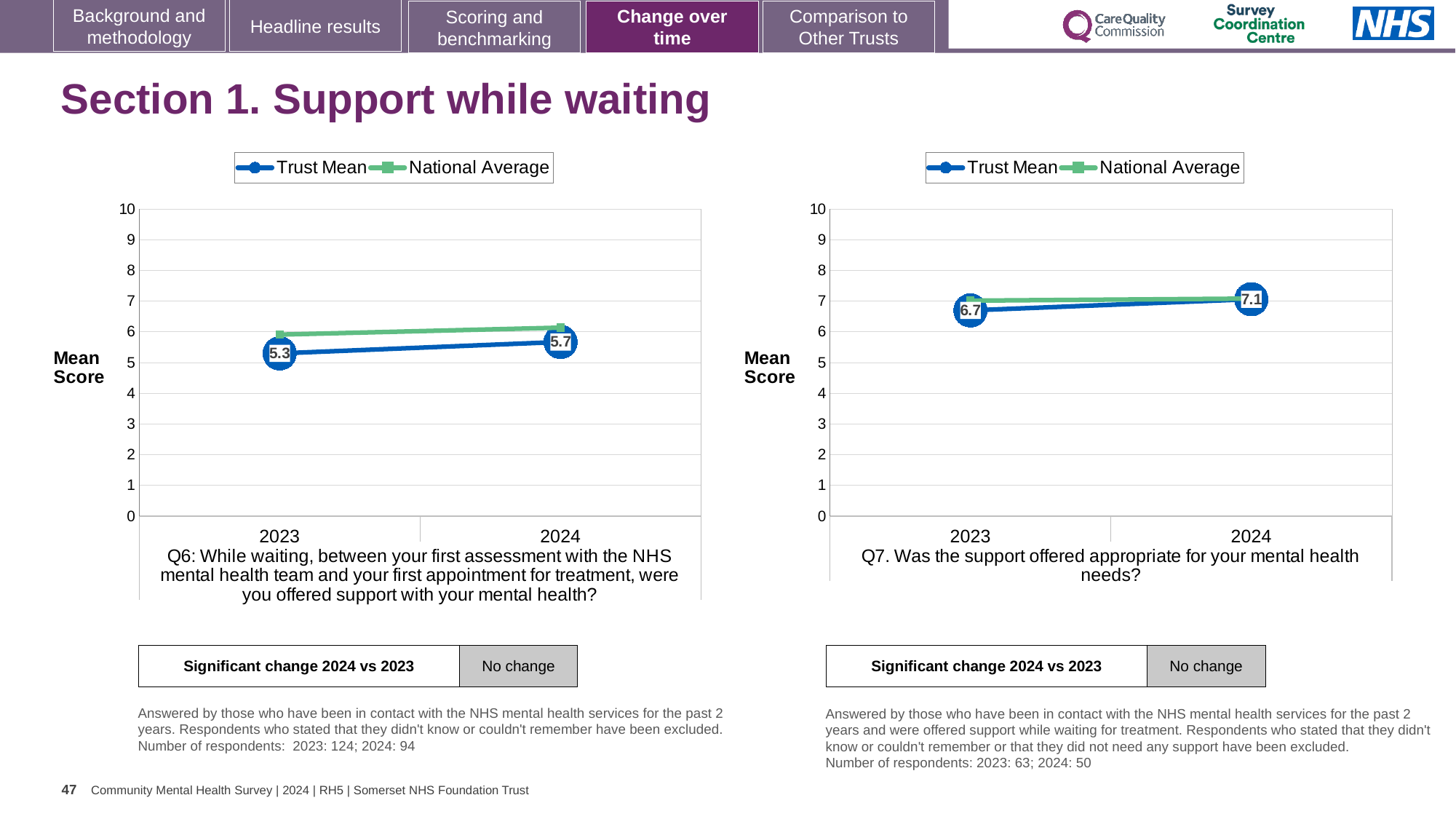
In the left chart (Q6), which series is higher in 2023, Trust Mean or National Average? National Average In the right chart (Q7), what is the Trust Mean score for 2024? 7.1 How many series does the legend of the right chart (Q7) list? 2 In the left chart (Q6), by how much did the Trust Mean change from 2023 to 2024? 0.4 What type of chart is the left chart (Q6)? line chart In the right chart (Q7), which year has the higher Trust Mean, 2023 or 2024? 2024 In the left chart (Q6), is the National Average for 2023 greater or less than 5? greater In the left chart (Q6), what is the Trust Mean score for 2024? 5.7 In the left chart (Q6), what is the Trust Mean score for 2023? 5.3 In the right chart (Q7), what is the Trust Mean score for 2023? 6.7 In the left chart (Q6), does the Trust Mean rise or fall from 2023 to 2024? rise In the right chart (Q7), what is the difference between the Trust Mean for 2024 and 2023? 0.4